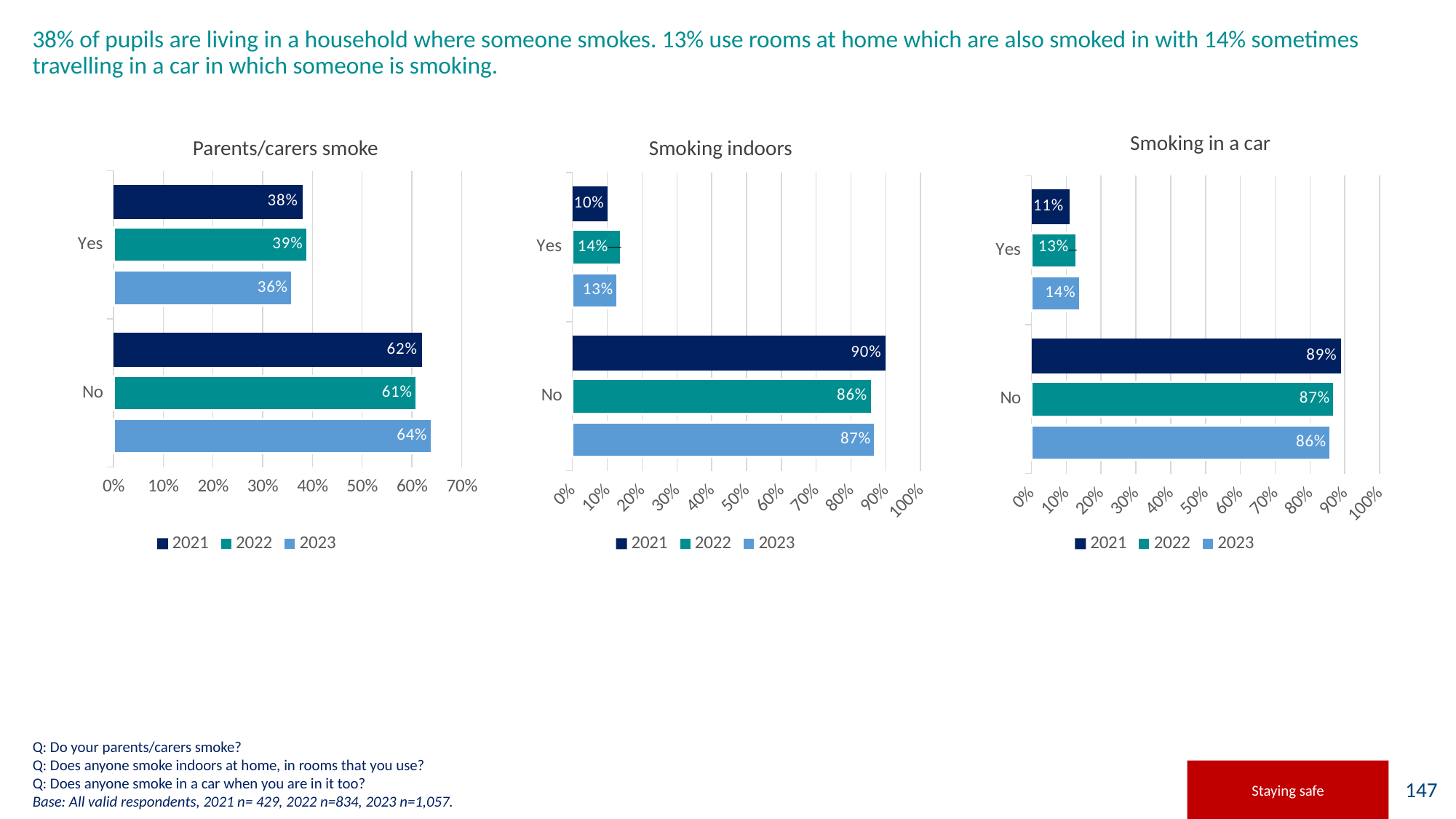
How many series does the legend list in the 'Smoking in a car' chart? 3 In the 'Smoking indoors' chart, which is larger: the 'Yes' value for 2022 or the 'Yes' value for 2023? 2022 In the 'Smoking in a car' chart, what is the difference between the 'No' value in 2021 and the 'Yes' value in 2021? 78% In the 'Smoking in a car' chart, what is the value for 'No' in 2021? 89% In the 'Parents/carers smoke' chart, what is the value for 'Yes' in 2021? 38% What kind of chart is the 'Parents/carers smoke' chart? Bar chart In the 'Smoking in a car' chart, which year has the lowest value for 'Yes'? 2021 In the 'Smoking indoors' chart, which year has the highest value for 'No'? 2021 What is the title of the middle chart on the slide? Smoking indoors In the 'Parents/carers smoke' chart, what is the value for 'No' in 2023? 64% In the 'Smoking indoors' chart, what is the value for 'Yes' in 2022? 14% In the 'Parents/carers smoke' chart, what is the difference between the 'No' value in 2023 and the 'No' value in 2022? 3%